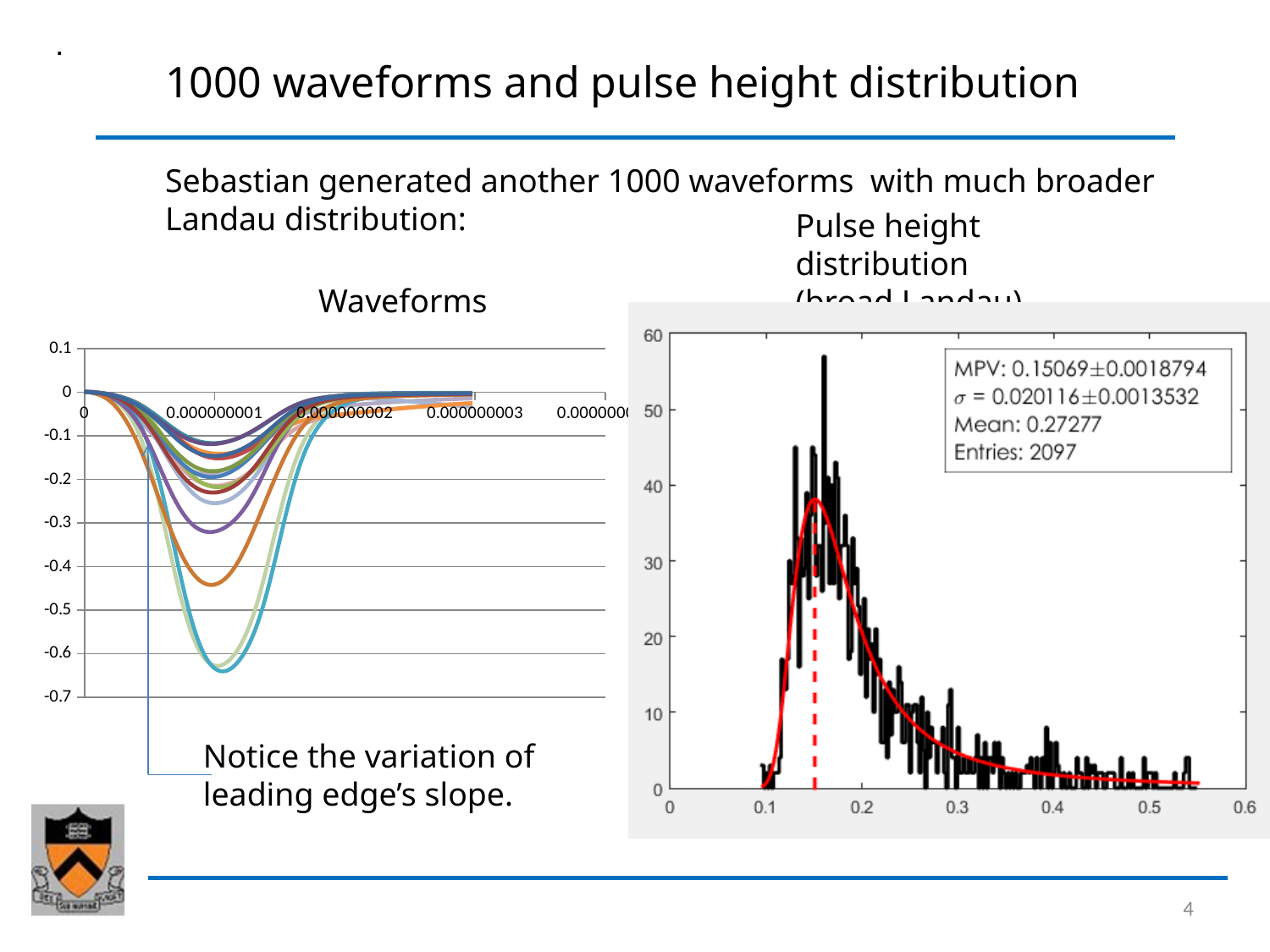
On the pulse height distribution chart, what MPV value is printed in the text box? 0.15069±0.0018794 On the pulse height distribution chart, what is the Mean printed in the text box? 0.27277 On the pulse height distribution chart, how many Entries are printed in the text box? 2097 On the pulse height distribution chart, is the height of the tallest bin greater or less than 50? greater What kind of chart is the Waveforms chart on the left? line chart On the Waveforms chart, is the minimum value reached by the shallowest waveform greater or less than -0.2? greater On the pulse height distribution chart, what value of σ is printed in the text box? 0.020116±0.0013532 On the Waveforms chart, is the minimum value reached by the deepest waveform greater or less than -0.6? less On the pulse height distribution chart, what colour is the fitted curve drawn over the histogram? red What is the title of the chart on the left of the slide? Waveforms